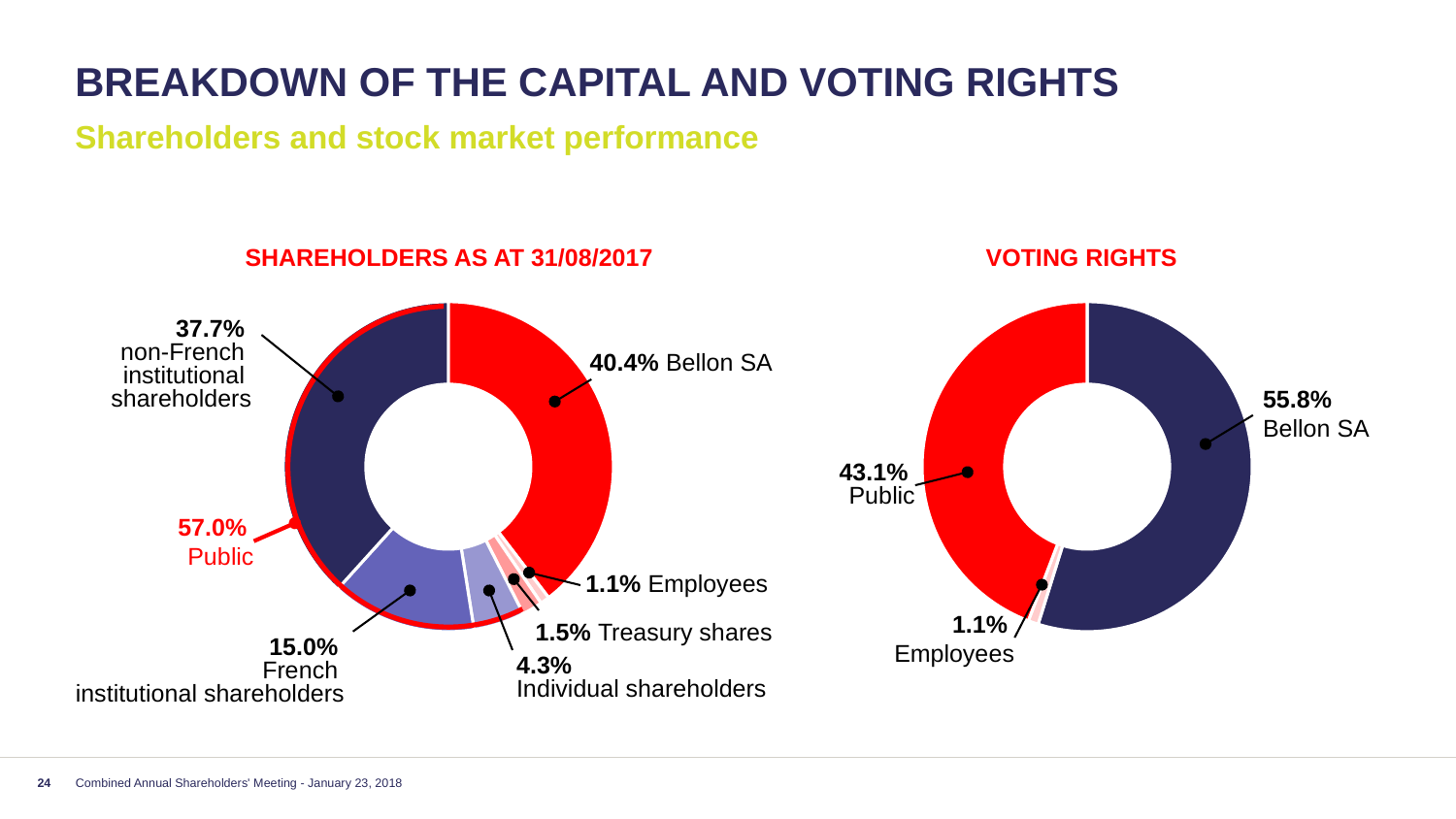
In the 'Shareholders as at 31/08/2017' chart, what share is held by French institutional shareholders? 15.0% In the 'Shareholders as at 31/08/2017' chart, which single shareholder category has the largest share? Bellon SA In the 'Voting Rights' chart, what share of voting rights does the Public hold? 43.1% In the 'Shareholders as at 31/08/2017' chart, what share of the capital is held by Bellon SA? 40.4% In the 'Voting Rights' chart, which holds more voting rights, Bellon SA or the Public? Bellon SA In the 'Shareholders as at 31/08/2017' chart, what share is held by non-French institutional shareholders? 37.7% In the 'Shareholders as at 31/08/2017' chart, what share is treasury shares? 1.5% In the 'Shareholders as at 31/08/2017' chart, what is the total share held by the Public? 57.0% In the 'Voting Rights' chart, what share of voting rights does Bellon SA hold? 55.8% In the 'Shareholders as at 31/08/2017' chart, what is the difference between the shares of non-French institutional shareholders and French institutional shareholders? 22.7 percentage points In the 'Shareholders as at 31/08/2017' chart, what share is held by individual shareholders? 4.3% What kind of chart is used for the 'Voting Rights' chart? Donut (pie) chart